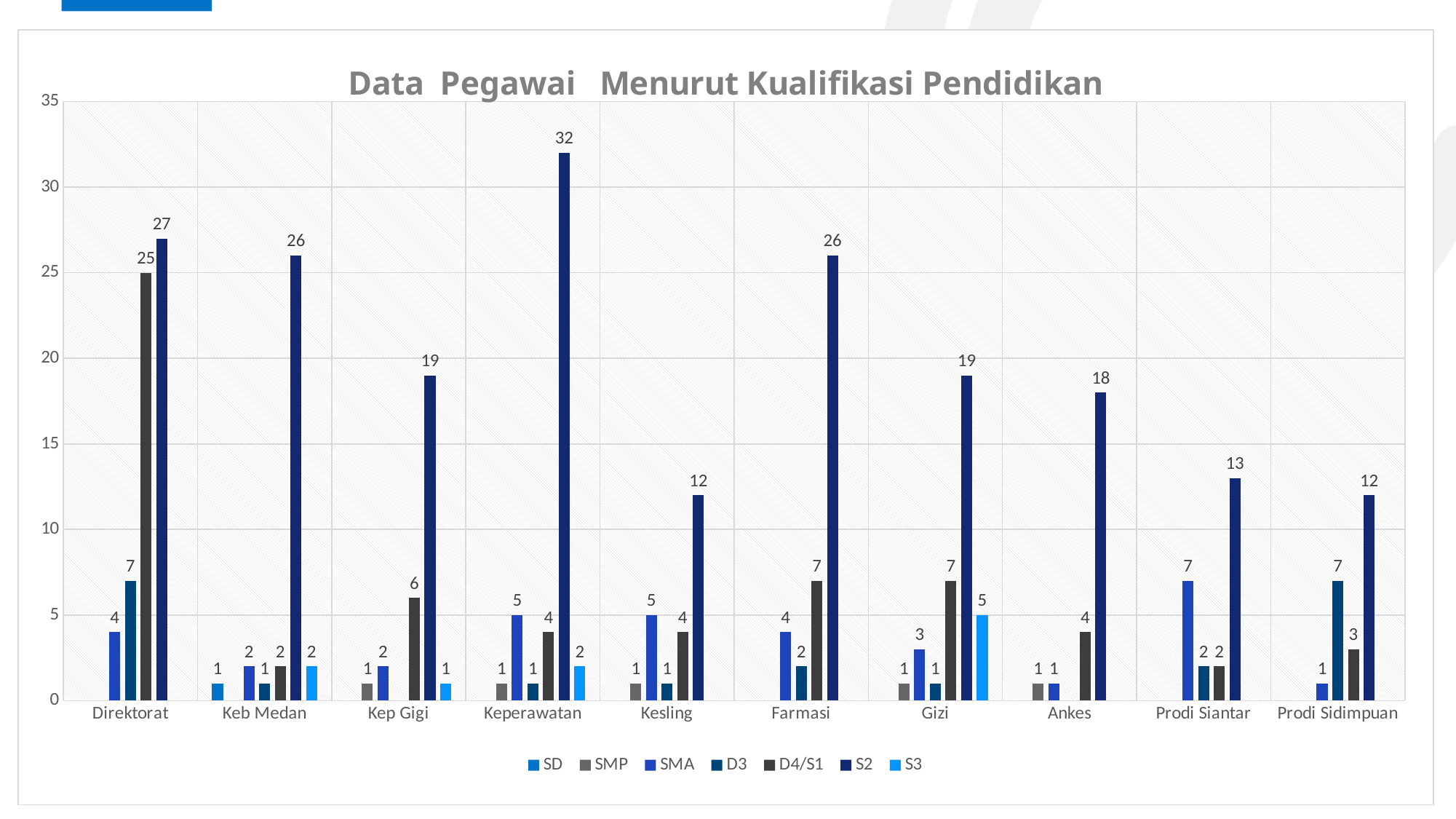
How many categories are shown on the x axis? 10 How many series does the legend list? 7 What is the difference between the S2 values for Keperawatan and Direktorat? 5 What is the value of the D4/S1 bar for Direktorat? 25 What kind of chart is shown on the slide? bar chart Which category has the lowest S2 value? Kesling and Prodi Sidimpuan (12) What is the title of the chart? Data Pegawai Menurut Kualifikasi Pendidikan Is the S2 value for Farmasi greater or less than 20? greater Which category has the highest S2 value? Keperawatan What is the value of the S2 bar for Prodi Siantar? 13 What is the value of the S2 bar for Keperawatan? 32 Which is larger, the S2 value for Gizi or the S2 value for Ankes? Gizi